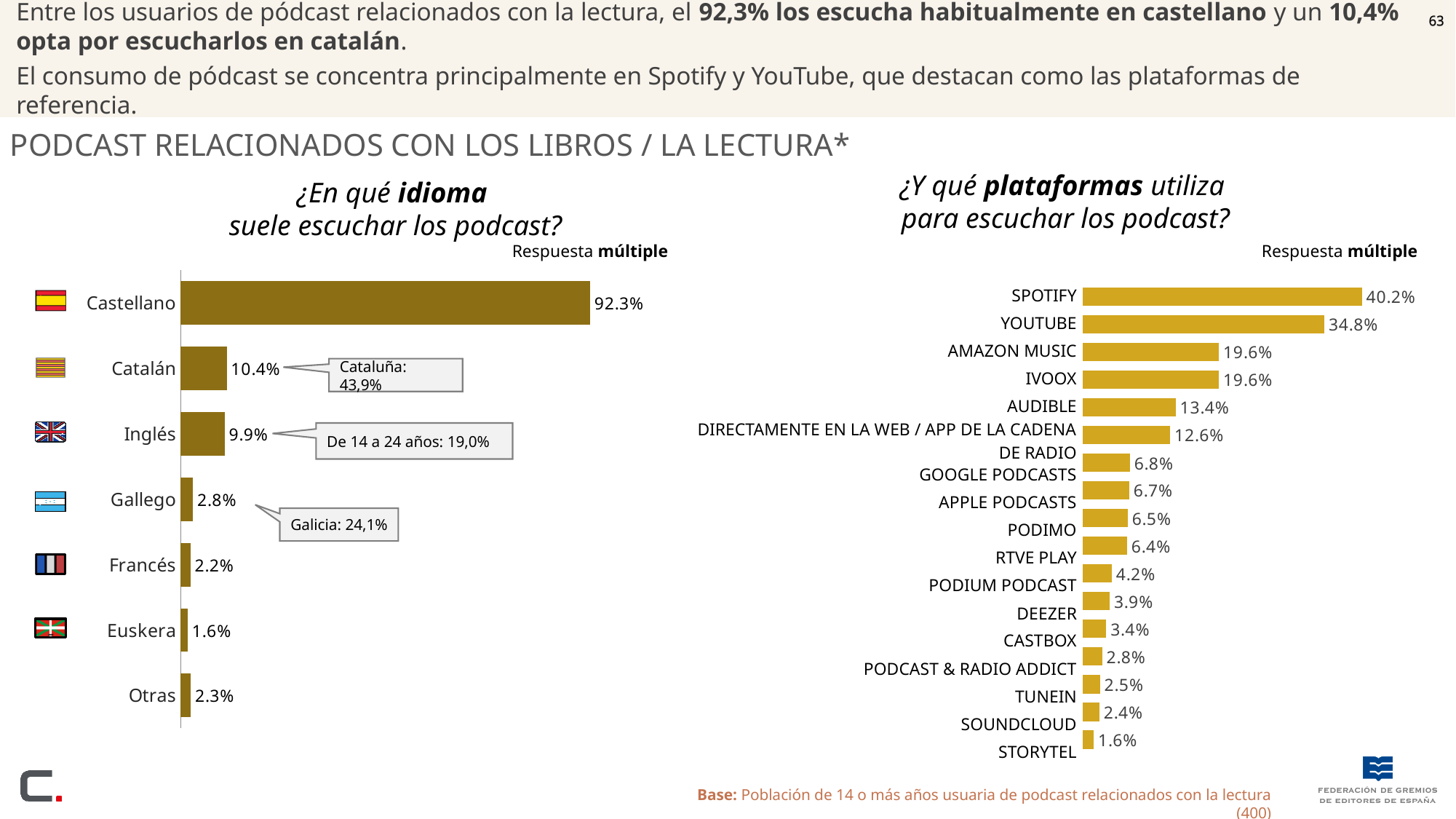
In the chart '¿En qué idioma suele escuchar los podcast?', what is the value for Castellano? 92.3% In the chart '¿En qué idioma suele escuchar los podcast?', what is the difference between Castellano and Catalán? 81.9 percentage points In the chart '¿En qué idioma suele escuchar los podcast?', how many language categories are shown? 7 In the chart '¿Y qué plataformas utiliza para escuchar los podcast?', which platform has the lowest value? STORYTEL In the chart '¿Y qué plataformas utiliza para escuchar los podcast?', how many platforms are listed? 17 In the chart '¿Y qué plataformas utiliza para escuchar los podcast?', what is the value for YOUTUBE? 34.8% What type of chart is used for '¿Y qué plataformas utiliza para escuchar los podcast?'? Bar chart In the chart '¿En qué idioma suele escuchar los podcast?', which language has the lowest value? Euskera In the chart '¿En qué idioma suele escuchar los podcast?', which is larger, Gallego or Francés? Gallego In the chart '¿Y qué plataformas utiliza para escuchar los podcast?', what is the value for SPOTIFY? 40.2% In the chart '¿En qué idioma suele escuchar los podcast?', what is the value for Inglés? 9.9% In the chart '¿Y qué plataformas utiliza para escuchar los podcast?', what is the difference between SPOTIFY and YOUTUBE? 5.4 percentage points